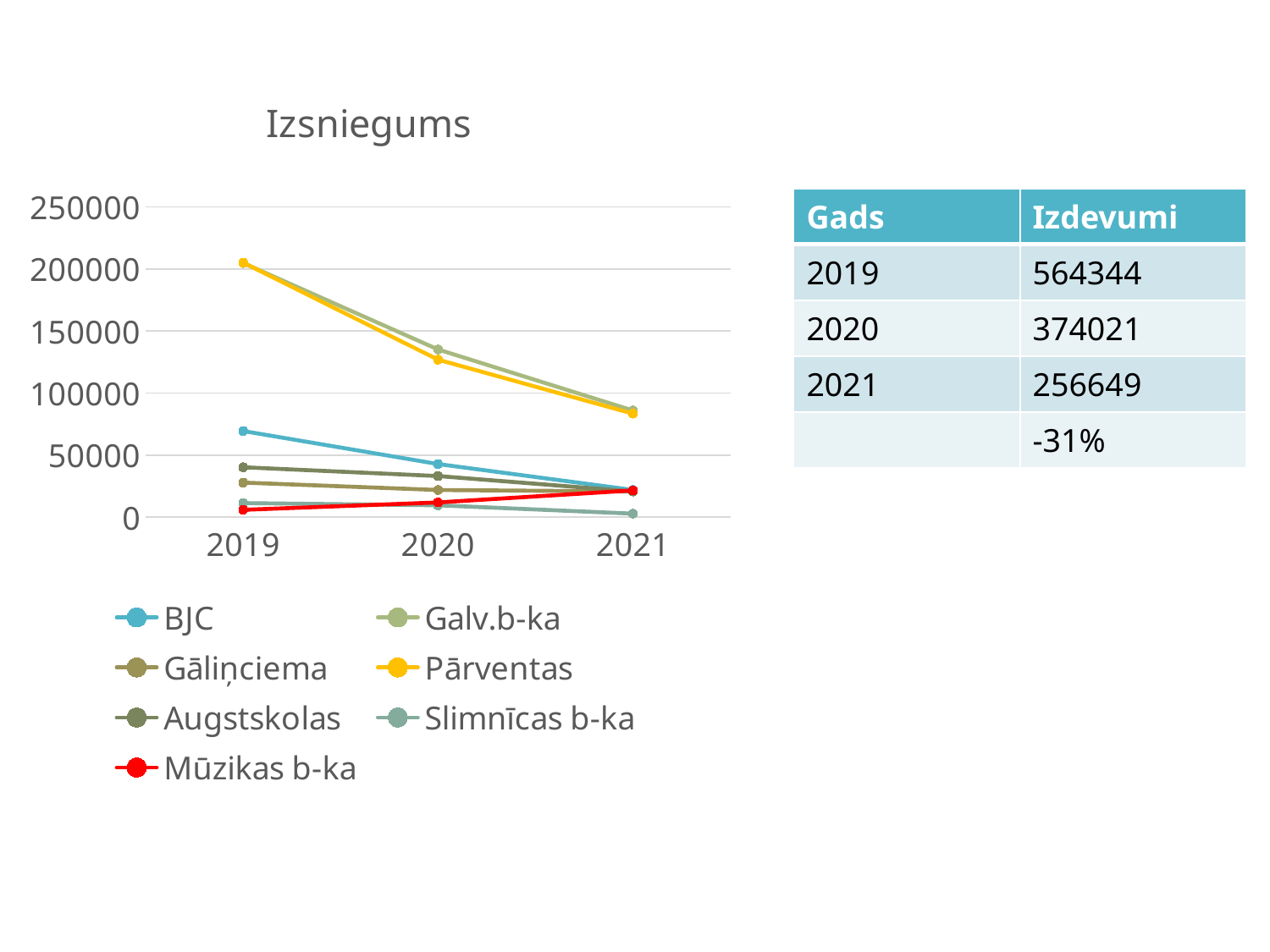
Is the value for Slimnīcas b-ka in 2021 greater or less than 50000? less How many series does the chart's legend list? 7 Does the BJC line rise or fall from 2019 to 2021? fall Which colour is used for the Mūzikas b-ka line in the legend? red Which series has the lowest value in 2021? Slimnīcas b-ka Does the Mūzikas b-ka line rise or fall from 2019 to 2021? rise Is the value for Galv.b-ka in 2020 greater or less than 100000? greater Is the value for BJC in 2019 greater or less than 50000? greater In 2019, which is larger: the value for BJC or the value for Augstskolas? BJC How many years are shown on the x axis of the chart? 3 What kind of chart is shown on the slide? line chart What is the title of the chart? Izsniegums